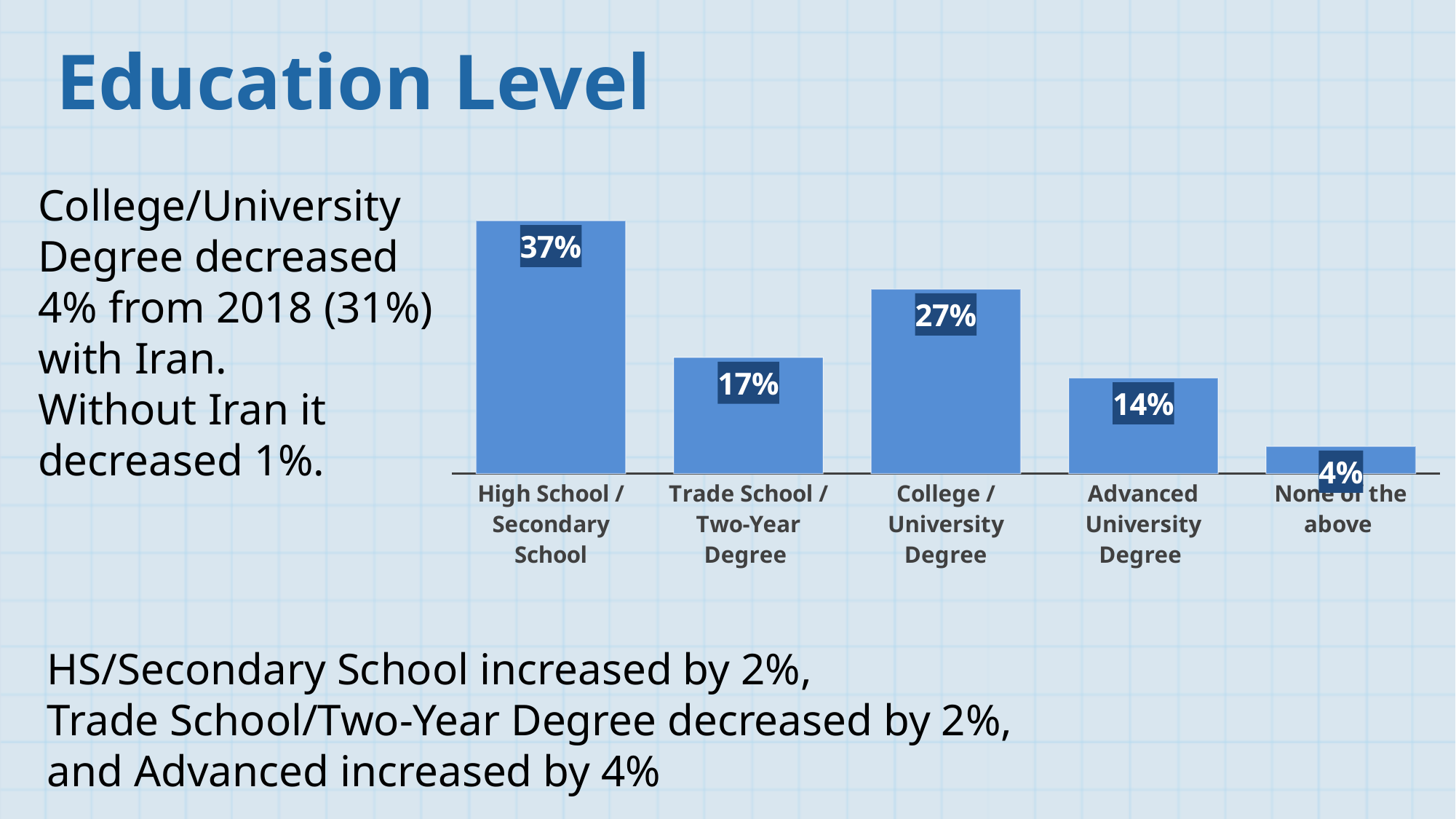
What is the value for College / University Degree? 27% Which category has the highest value? High School / Secondary School How many categories are shown in the chart? 5 What kind of chart is shown on the slide? Bar chart What is the difference between the values for High School / Secondary School and College / University Degree? 10% What is the value for High School / Secondary School? 37% What is the value for None of the above? 4% Which category has the lowest value? None of the above Which is larger, the value for Trade School / Two-Year Degree or Advanced University Degree? Trade School / Two-Year Degree What is the value for Trade School / Two-Year Degree? 17% What is the value for Advanced University Degree? 14% What is the title of the slide containing the chart? Education Level